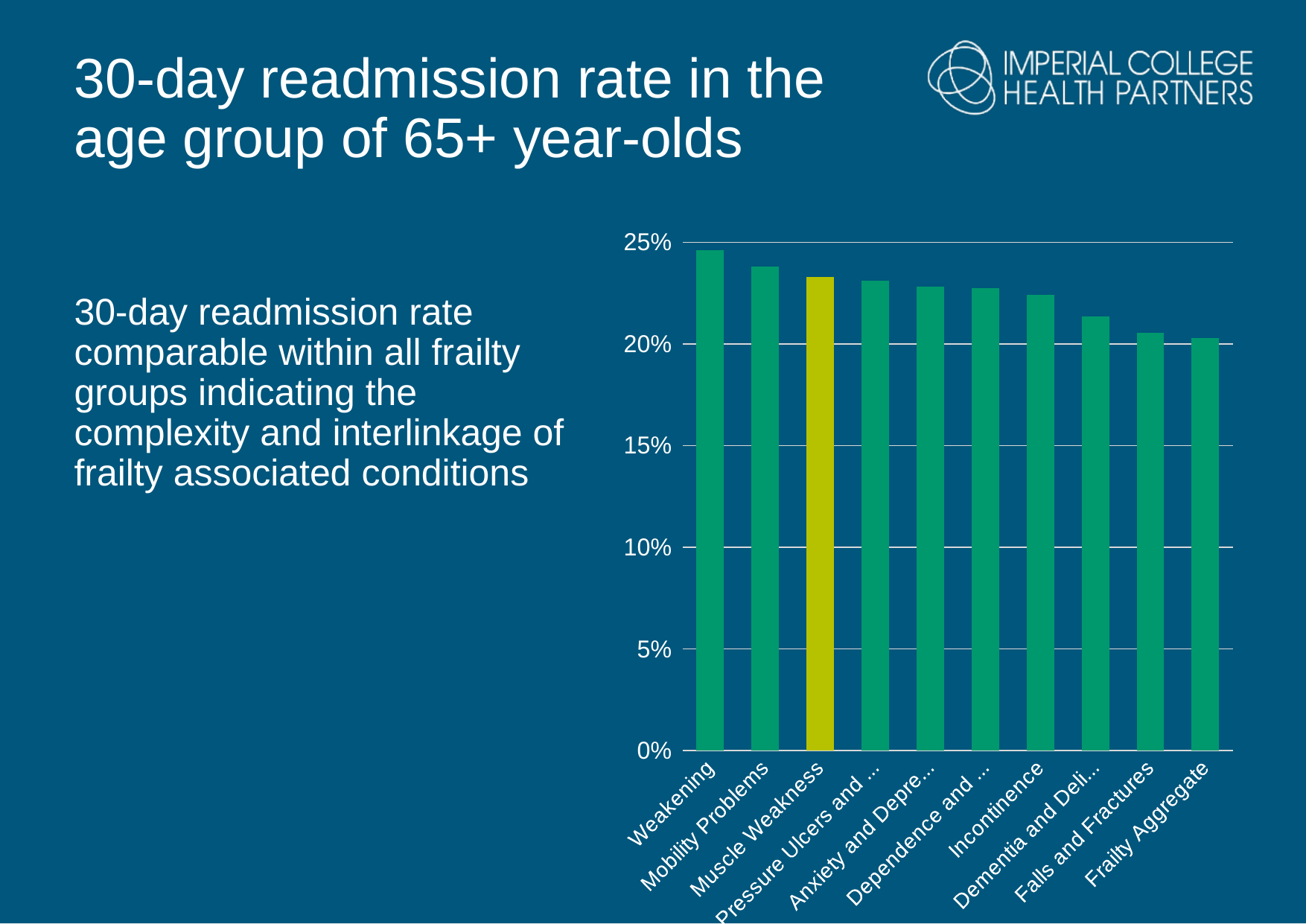
Is the value for Weakening greater or less than 20%? greater Which category's bar is shown in a different colour (yellow) from the others? Muscle Weakness What kind of chart is shown on the slide? bar chart What is the highest value shown on the y axis? 25% Which is larger, the value for Mobility Problems or the value for Falls and Fractures? Mobility Problems Is the value for Incontinence greater or less than 20%? greater Do the values generally rise or fall from left to right along the x axis? fall How many categories are plotted on the chart? 10 Is the value for Weakening greater or less than 25%? less Which is larger, the value for Weakening or the value for Frailty Aggregate? Weakening Which category has the highest 30-day readmission rate? Weakening